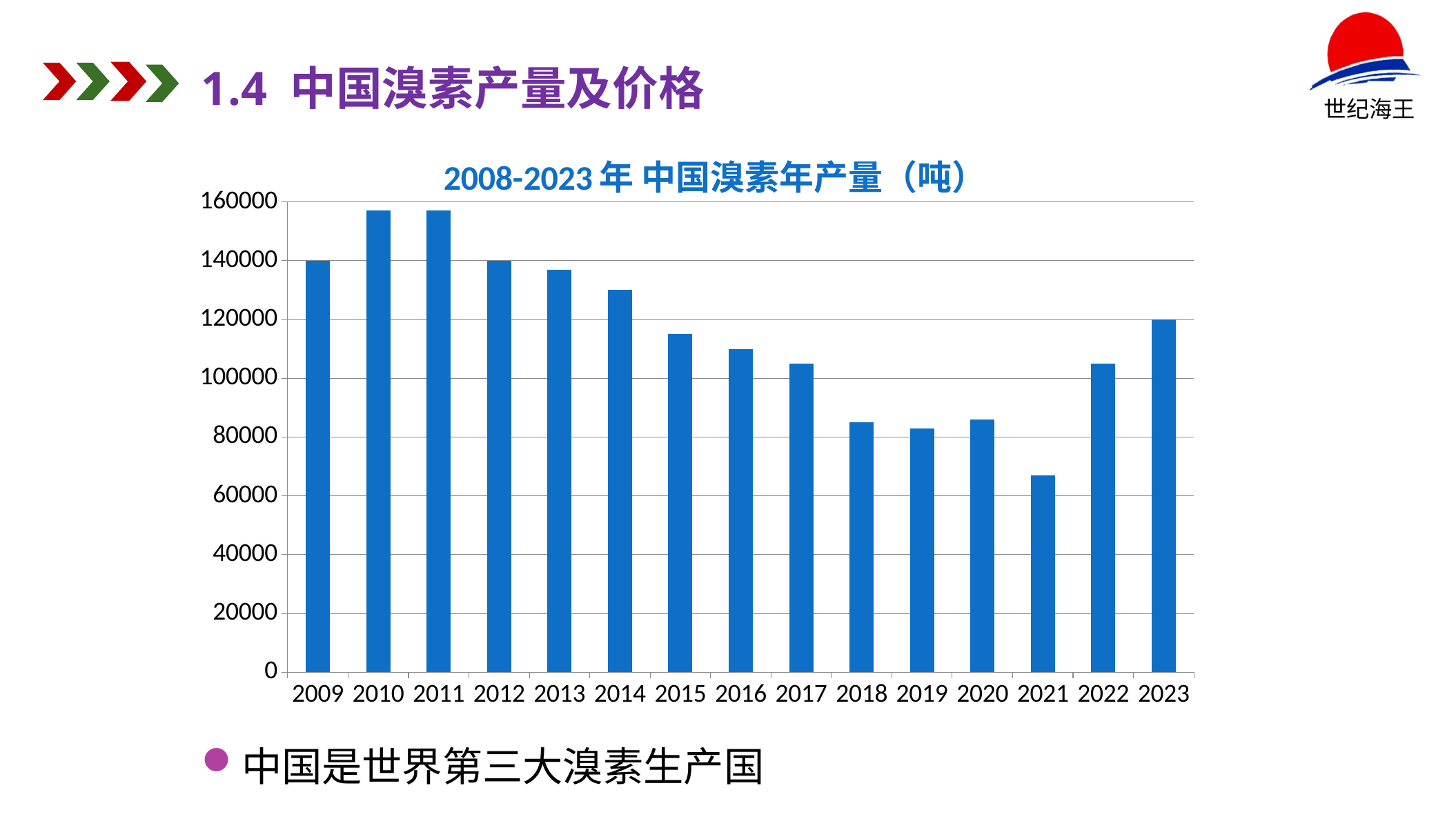
What is the bromine production value for 2009? 140000 Which is larger, the value for 2015 or the value for 2018? 2015 How many years are shown on the x axis of the chart? 15 What is the title of the chart? 2008-2023 年 中国溴素年产量（吨） Do the values generally rise or fall from 2011 to 2021? fall Is the value for 2021 greater or less than 80000? less Is the value for 2016 greater or less than 100000? greater What kind of chart is shown on the slide? bar chart Which is larger, the value for 2022 or the value for 2021? 2022 What is the bromine production value for 2023? 120000 Which year has the lowest bromine production in the chart? 2021 Is the value for 2014 greater or less than 120000? greater